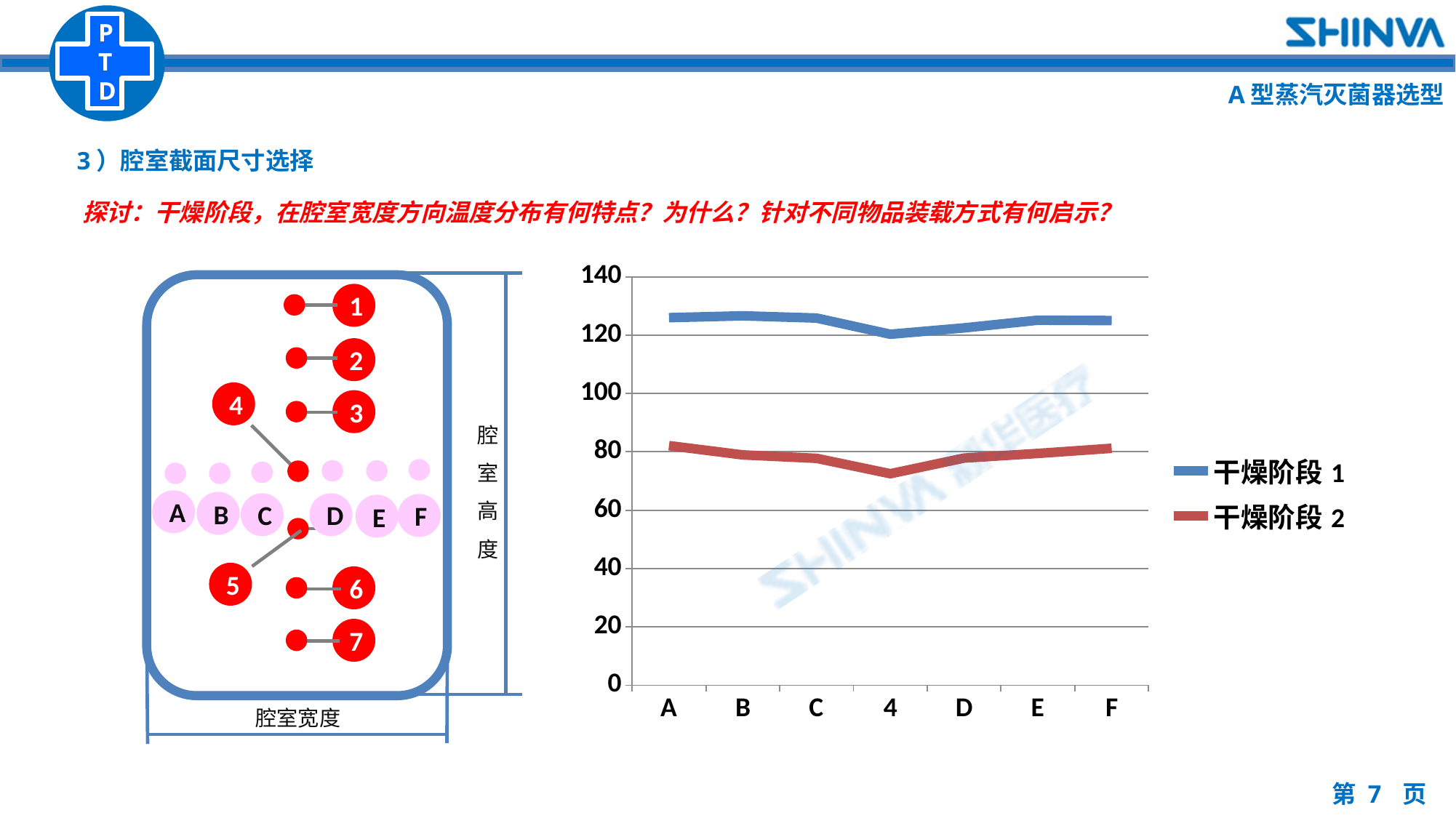
Is the value for 干燥阶段 2 at category C greater or less than 100? less Is the value for 干燥阶段 1 at category A greater or less than 120? greater Do the values for 干燥阶段 2 rise or fall from category 4 to category F? rise How many categories are shown on the x axis of the chart? 7 How many series does the chart legend list? 2 Is the value for 干燥阶段 1 at category 4 greater or less than 100? greater What kind of chart is shown on the slide? line chart What colour is the line for 干燥阶段 1? blue Which category has the lowest value for 干燥阶段 2? 4 Which series has the larger value at category C, 干燥阶段 1 or 干燥阶段 2? 干燥阶段 1 Which category has the lowest value for 干燥阶段 1? 4